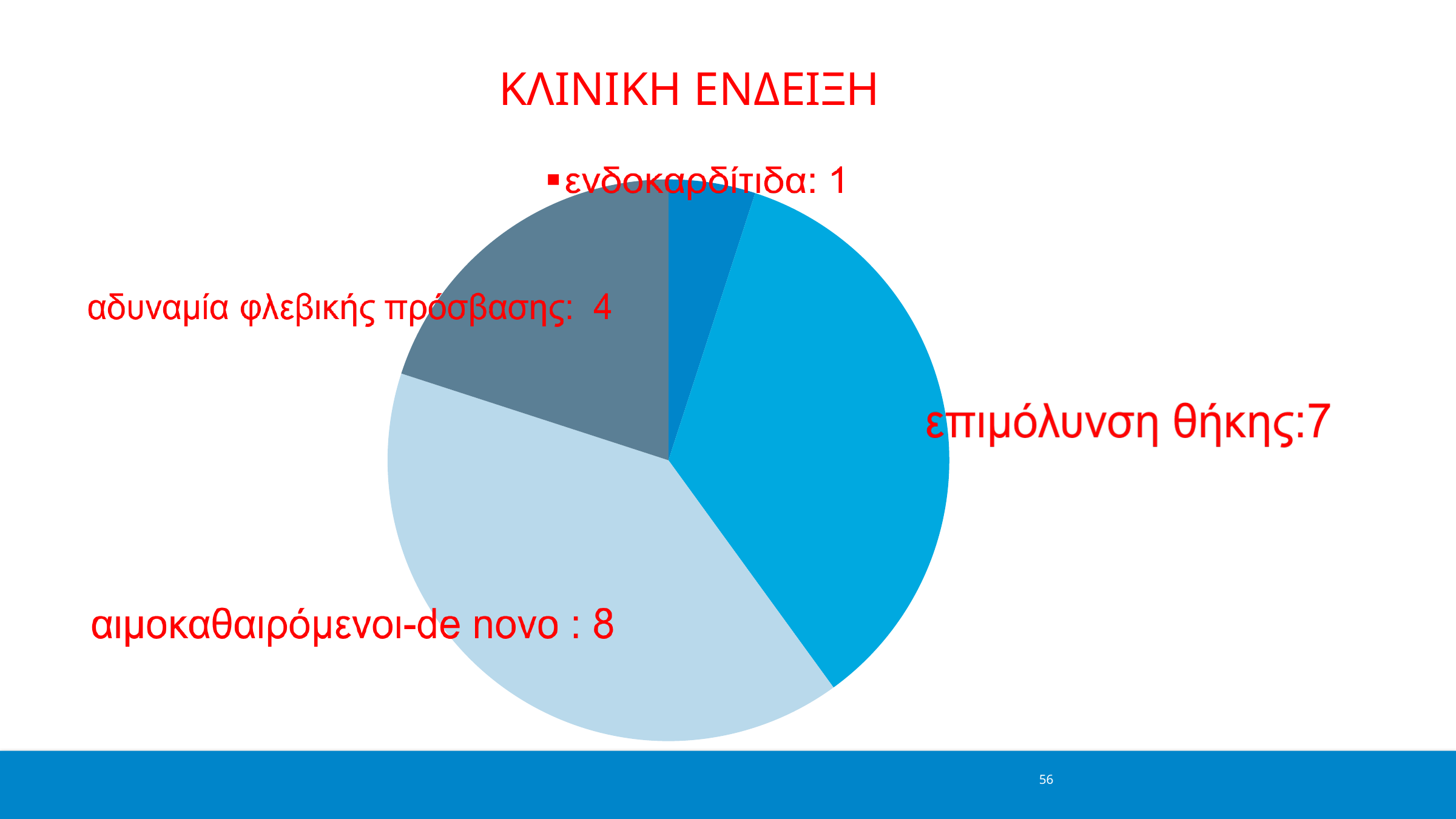
Which category has the smallest slice? ενδοκαρδίτιδα What is the value for επιμόλυνση θήκης? 7 What is the value for αιμοκαθαιρόμενοι-de novo? 8 What is the value for αδυναμία φλεβικής πρόσβασης? 4 What share of the pie does αιμοκαθαιρόμενοι-de novo represent? 40% How many slices does the pie chart have? 4 What type of chart is shown on the slide? pie chart What is the difference between the values for αιμοκαθαιρόμενοι-de novo and αδυναμία φλεβικής πρόσβασης? 4 Which is larger, επιμόλυνση θήκης or αδυναμία φλεβικής πρόσβασης? επιμόλυνση θήκης Which category has the largest slice? αιμοκαθαιρόμενοι-de novo What is the title of the chart? ΚΛΙΝΙΚΗ ΕΝΔΕΙΞΗ What is the value for ενδοκαρδίτιδα? 1